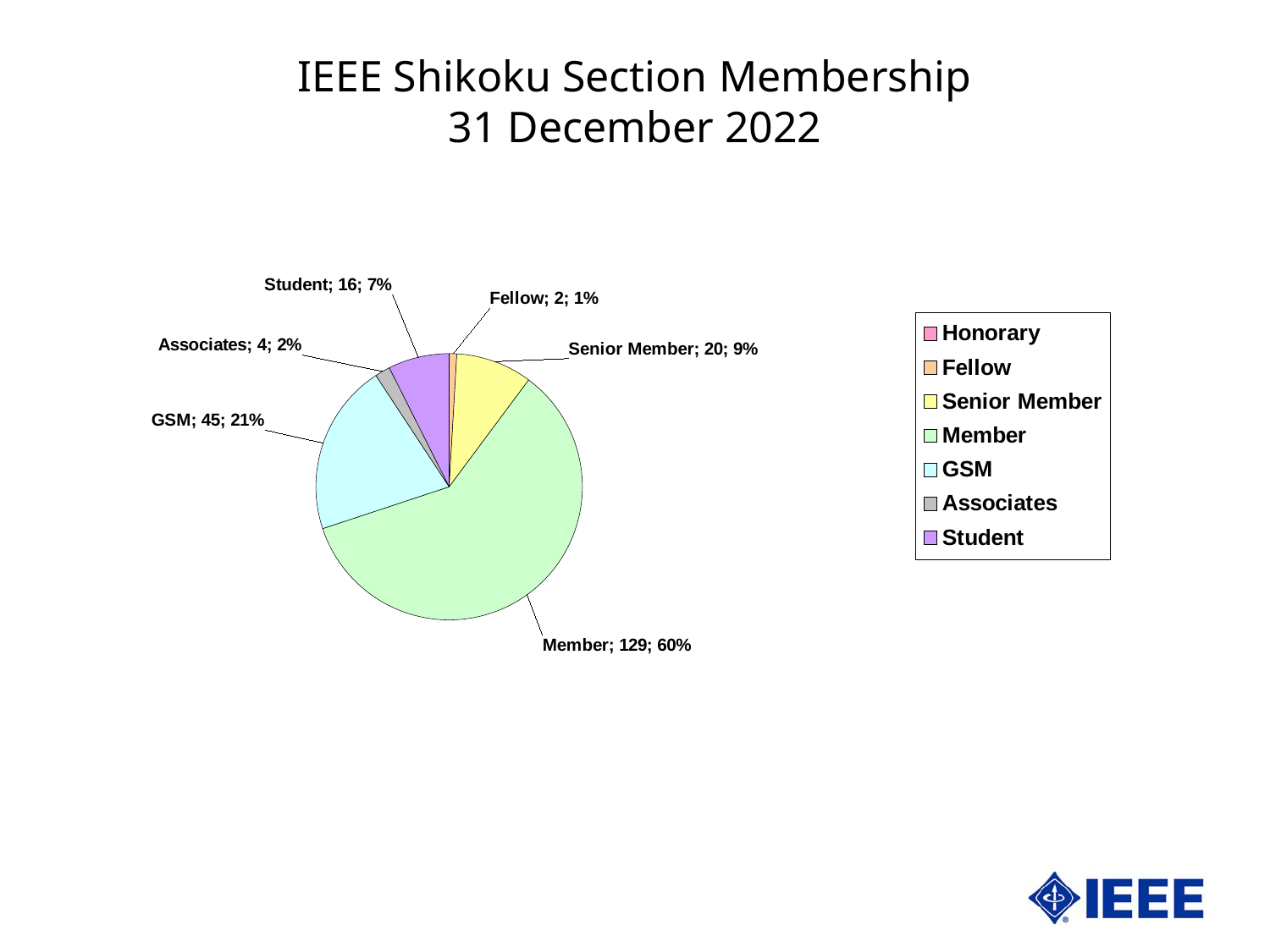
How many members are in the Senior Member category? 20 What is the title of the slide containing the chart? IEEE Shikoku Section Membership 31 December 2022 How many members are in the Member category? 129 What kind of chart is shown on the slide? pie chart Which labelled category has the smallest slice of the pie? Fellow Which is larger, the Senior Member count or the Student count? Senior Member What percentage of the pie does the GSM slice represent? 21% Which category has the largest slice of the pie? Member How many entries does the legend list? 7 What share of the pie does the Student slice represent? 7% What is the difference between the number of Members and the number of GSM members? 84 How many members are in the Associates category? 4